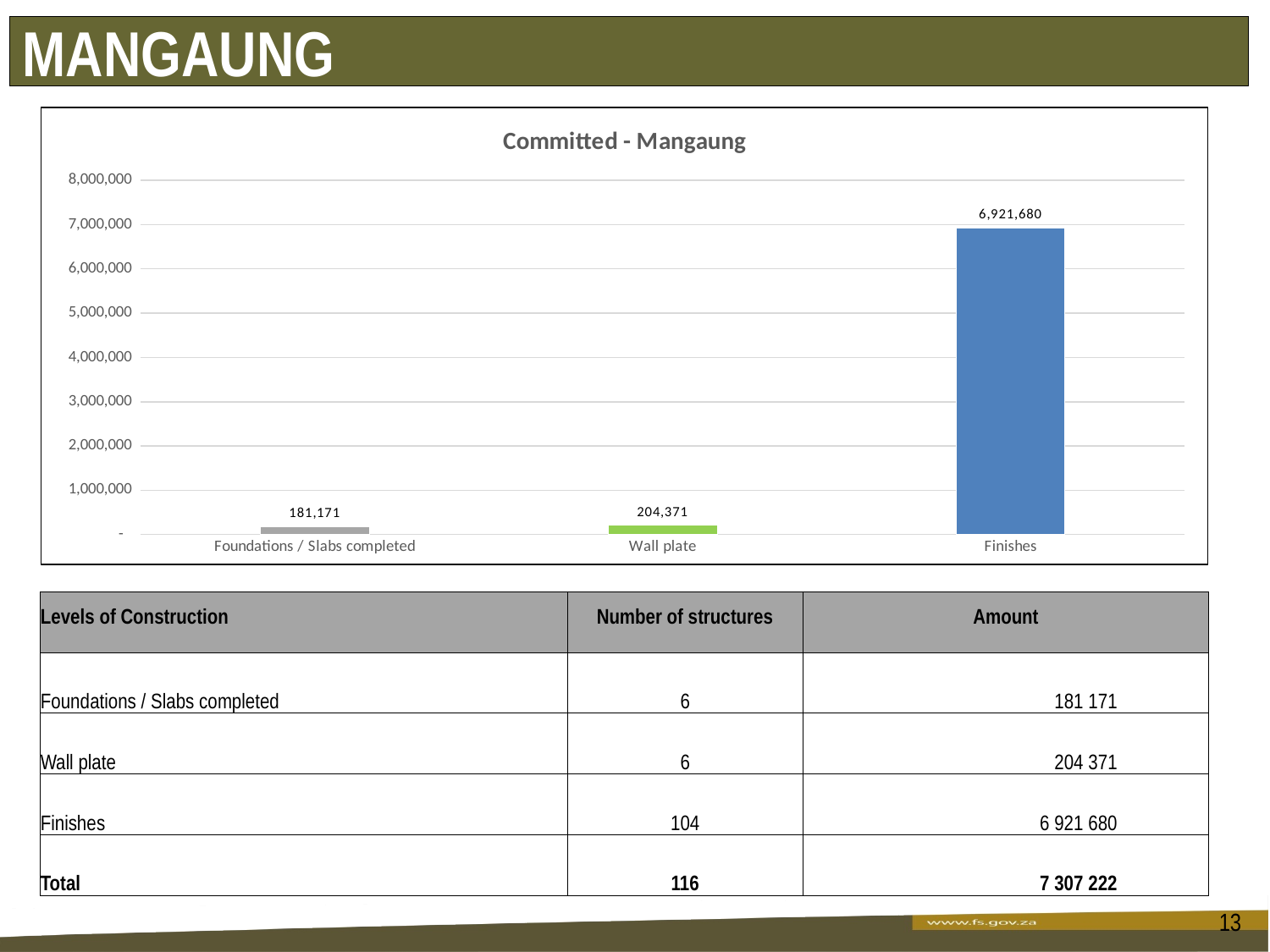
How many categories are shown in the Committed - Mangaung chart? 3 Which is larger in the Committed - Mangaung chart, Wall plate or Foundations / Slabs completed? Wall plate Which category has the highest value in the Committed - Mangaung chart? Finishes What is the value for Foundations / Slabs completed in the Committed - Mangaung chart? 181,171 What is the difference between the values for Wall plate and Foundations / Slabs completed in the Committed - Mangaung chart? 23,200 What is the value for Wall plate in the Committed - Mangaung chart? 204,371 What is the title of the chart on the slide? Committed - Mangaung What is the difference between the values for Finishes and Wall plate in the Committed - Mangaung chart? 6,717,309 What is the value for Finishes in the Committed - Mangaung chart? 6,921,680 What kind of chart is the Committed - Mangaung chart? bar chart Is the value for Finishes in the Committed - Mangaung chart greater or less than 6,000,000? greater Which category has the lowest value in the Committed - Mangaung chart? Foundations / Slabs completed